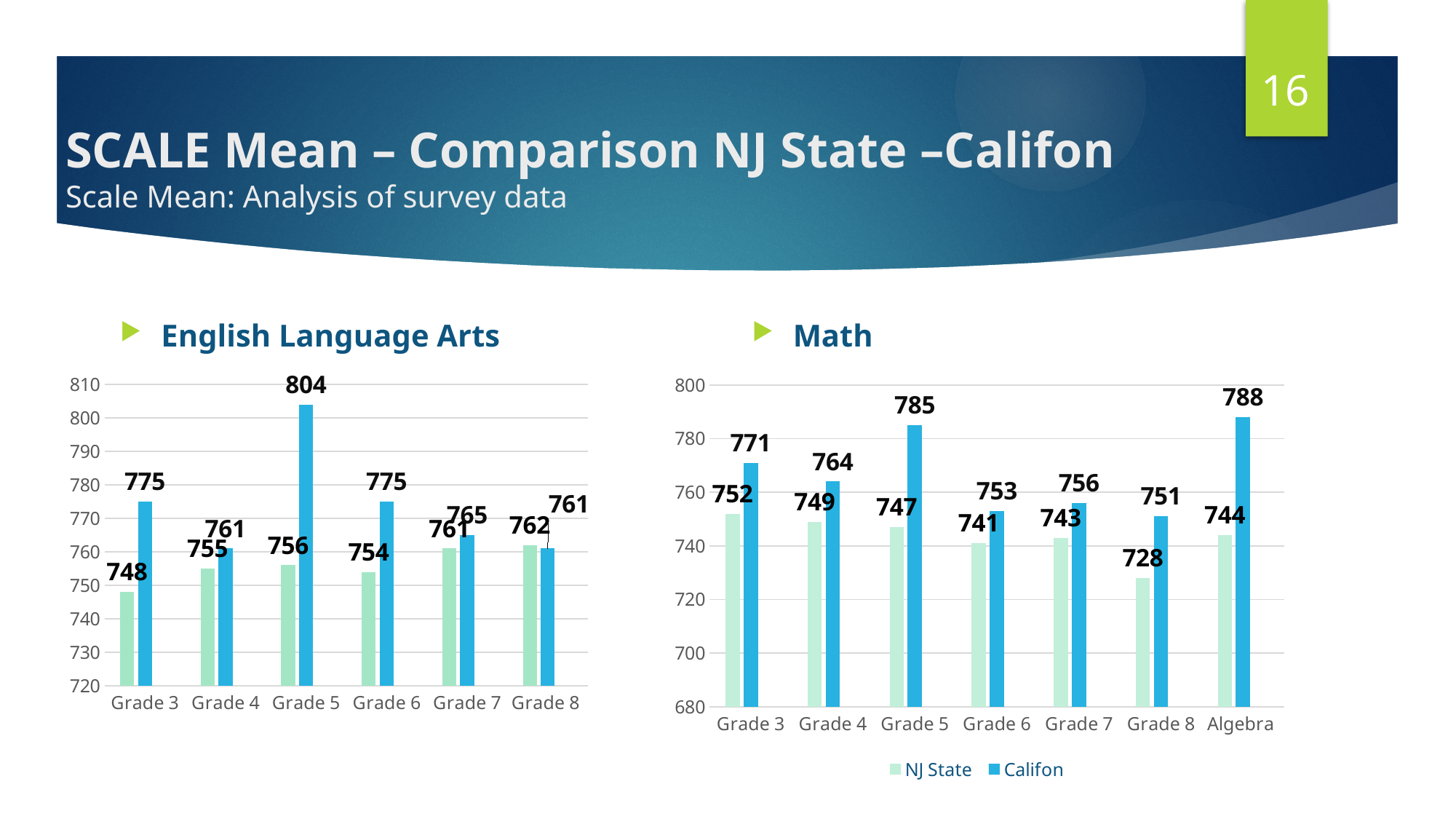
What type of chart is the Math chart? Bar chart In the English Language Arts chart, what is the value of the blue bar for Grade 5? 804 In the Math chart, what is the Califon value for Algebra? 788 In the English Language Arts chart, what is the value of the light green bar for Grade 3? 748 In the English Language Arts chart, how many grade categories are shown on the x axis? 6 In the Math chart, which is larger for Grade 6: the NJ State value or the Califon value? Califon In the Math chart, what is the NJ State value for Grade 8? 728 In the English Language Arts chart, what is the difference between the blue bar and the light green bar for Grade 5? 48 In the Math chart, what is the difference between the Califon and NJ State values for Grade 3? 19 How many series does the legend of the Math chart list? 2 In the English Language Arts chart, which grade has the highest blue bar? Grade 5 In the Math chart, which category has the lowest NJ State value? Grade 8